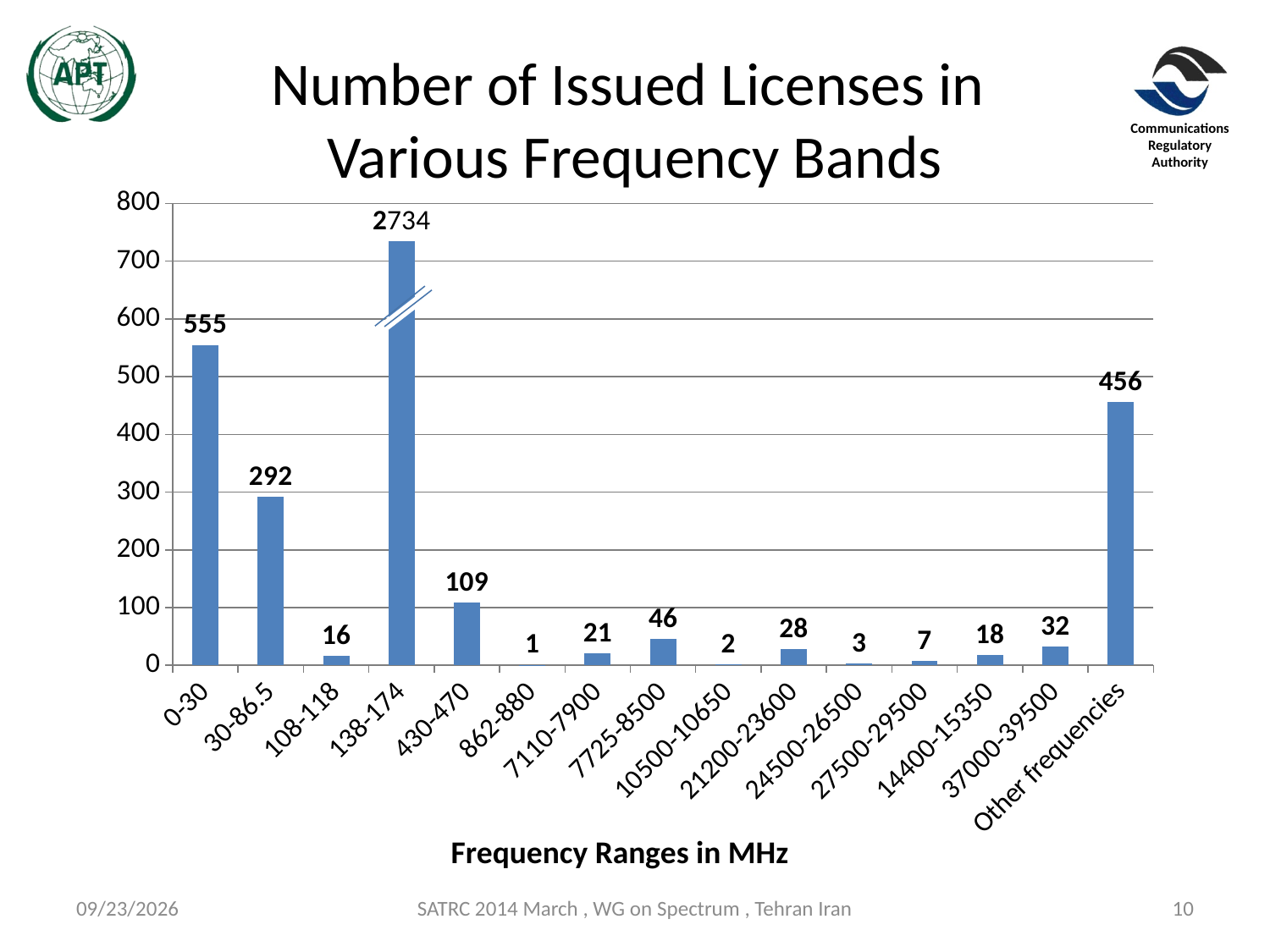
What is the difference between the values for 0-30 and Other frequencies? 99 Which has more issued licenses, the 430-470 band or the 7725-8500 band? 430-470 What is the difference between the values for 21200-23600 and 14400-15350? 10 Which frequency band has the highest number of issued licenses? 138-174 How many licenses were issued in the 0-30 MHz band? 555 What is the value shown for the 30-86.5 MHz band? 292 What type of chart is shown on the slide? bar chart What is the value labelled for the 138-174 MHz band? 2734 How many frequency range categories are plotted on the x axis? 15 How many licenses are shown for 'Other frequencies'? 456 Which frequency band has the lowest number of issued licenses? 862-880 What is the x-axis title of the chart? Frequency Ranges in MHz